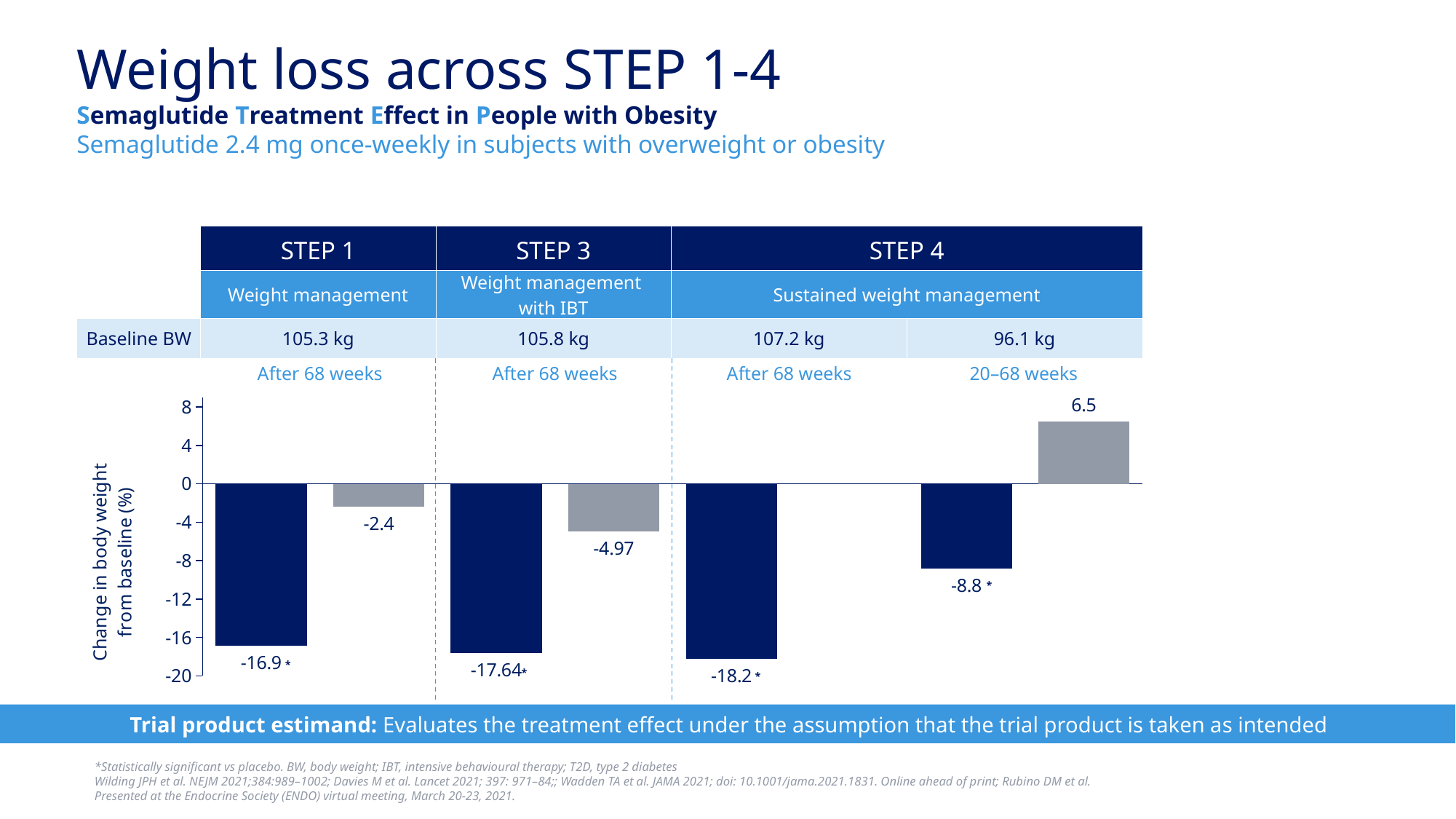
What is the value of the grey bar in STEP 3 after 68 weeks? -4.97 What is the value of the grey bar in STEP 1 after 68 weeks? -2.4 Which bar has the highest value on the chart? STEP 4 20–68 weeks grey bar (6.5) What is the change in body weight from baseline for the dark blue bar in STEP 1 after 68 weeks? -16.9 What is the value of the dark blue bar in STEP 3 (weight management with IBT) after 68 weeks? -17.64 Is the dark blue bar in STEP 3 (-17.64) lower than the dark blue bar in STEP 1 (-16.9)? Yes What is the change in body weight for the dark blue bar in STEP 4 after 68 weeks? -18.2 What is the value of the grey bar in STEP 4 for 20–68 weeks? 6.5 What type of chart is shown on the slide? Bar chart Which bar shows the largest weight loss (most negative value) on the chart? STEP 4 after 68 weeks (-18.2) What is the difference between the dark blue bar and the grey bar in STEP 1 after 68 weeks? 14.5 How many bars are plotted on the chart? 7